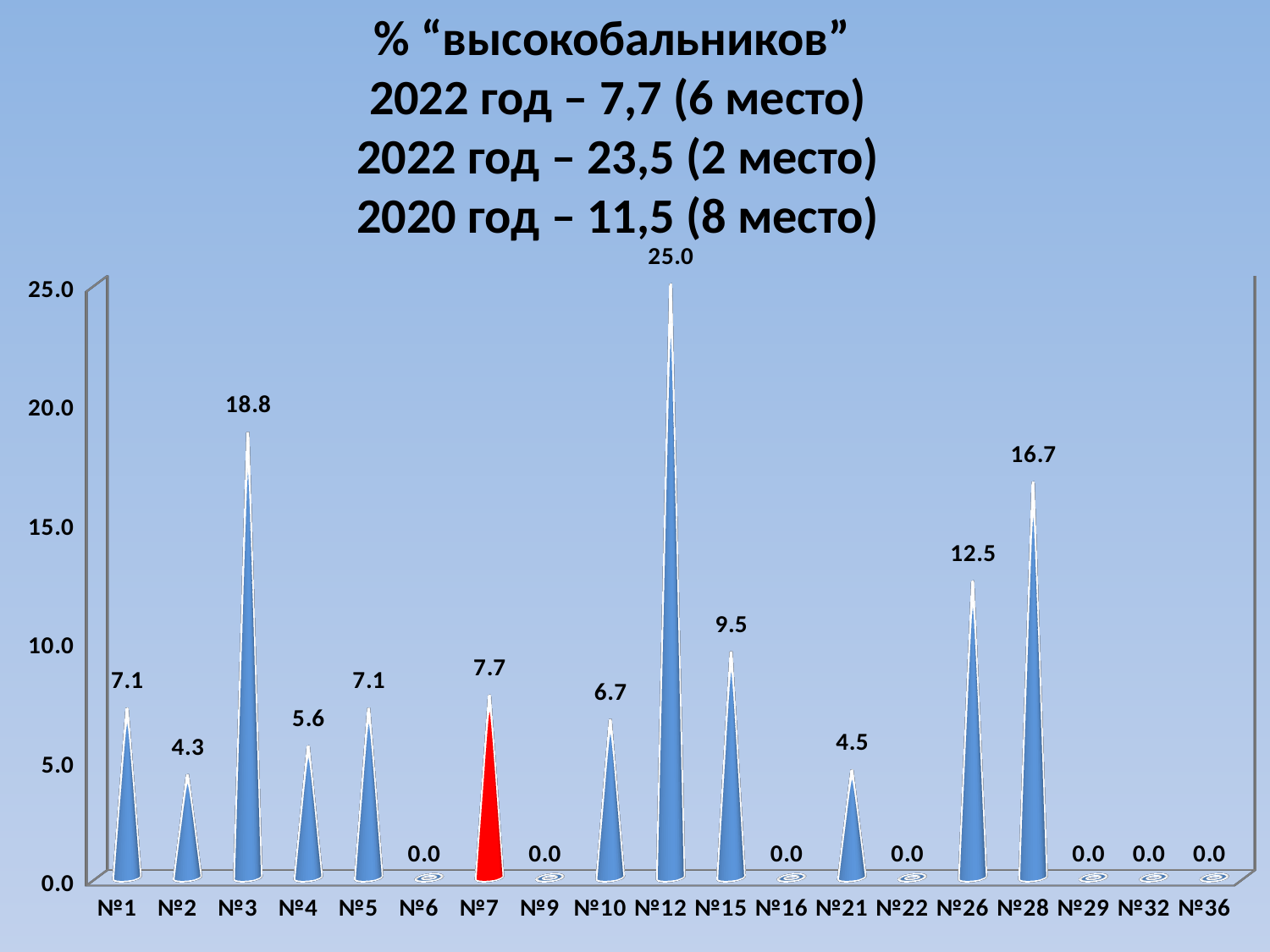
How many categories have a value of 0.0? 7 What kind of chart is this? bar chart What is the value for №3? 18.8 How many categories are shown on the x axis? 19 Which category has the highest value? №12 Which category's bar is coloured red? №7 What is the value for №7, the red bar? 7.7 Which is larger, the value for №10 or the value for №15? №15 Is the value for №28 greater or less than 15.0? greater What is the difference between the values for №26 and №15? 3.0 What is the difference between the values for №12 and №3? 6.2 What is the value for №28? 16.7